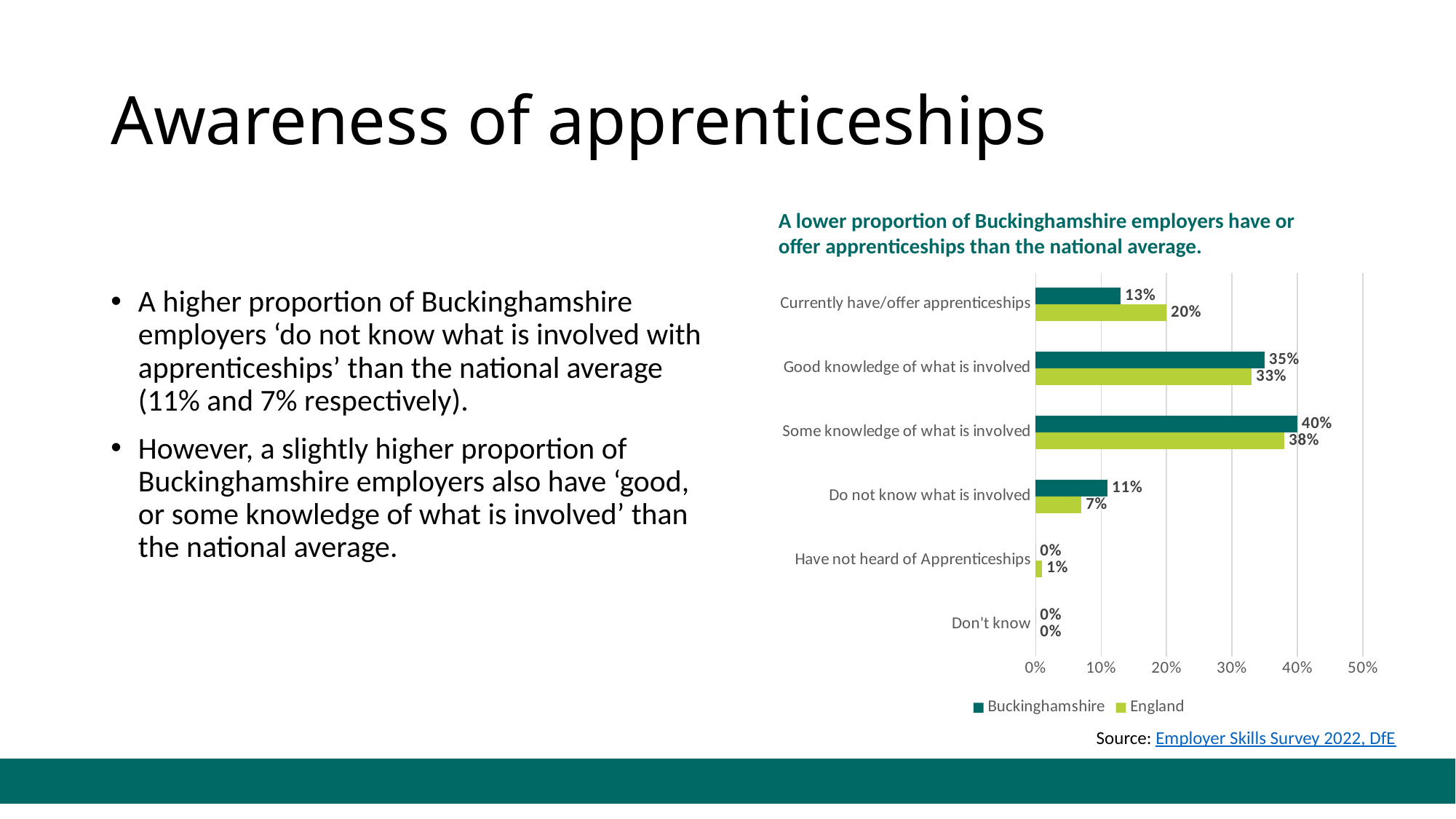
What is the difference between the Buckinghamshire and England values for 'Some knowledge of what is involved'? 2% Which category has the highest Buckinghamshire value? Some knowledge of what is involved What kind of chart is shown on the slide? Bar chart What is the Buckinghamshire value for 'Currently have/offer apprenticeships'? 13% What is the title of the chart? A lower proportion of Buckinghamshire employers have or offer apprenticeships than the national average. What is the England value for 'Good knowledge of what is involved'? 33% What is the England value for 'Do not know what is involved'? 7% What is the difference between the England and Buckinghamshire values for 'Currently have/offer apprenticeships'? 7% For 'Have not heard of Apprenticeships', which is larger: Buckinghamshire or England? England How many categories are shown on the chart? 6 For 'Good knowledge of what is involved', which is larger: Buckinghamshire or England? Buckinghamshire How many series does the legend list? 2